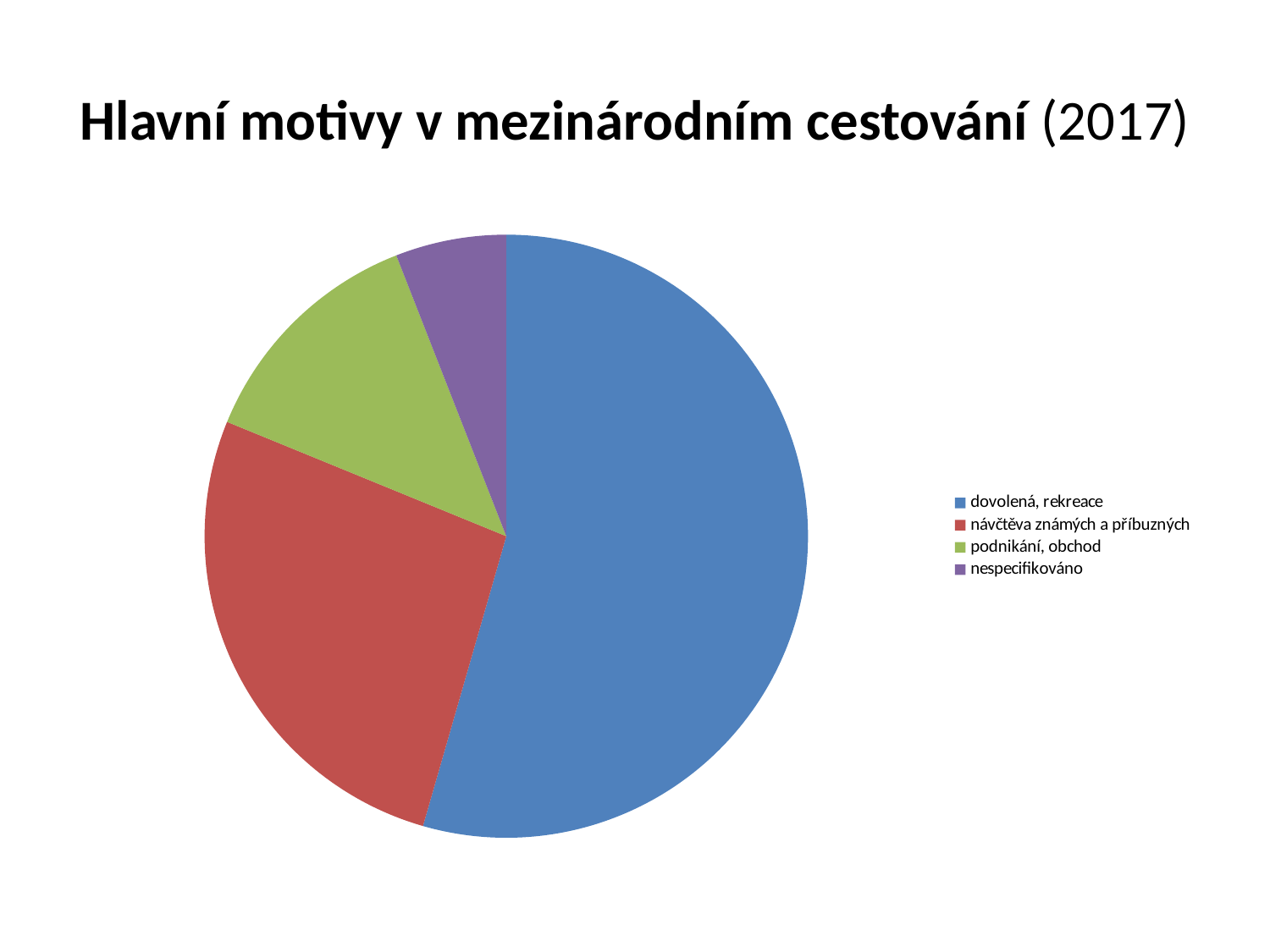
What kind of chart is shown on the slide? pie chart Does the slice for dovolená, rekreace take up more or less than half of the pie? more Which category has the largest slice of the pie? dovolená, rekreace What is the title of the slide's chart? Hlavní motivy v mezinárodním cestování (2017) What colour is the slice for podnikání, obchod? green Which slice is larger: dovolená, rekreace or návčtěva známých a příbuzných? dovolená, rekreace Which category has the smallest slice of the pie? nespecifikováno How many slices does the pie chart have? 4 Which slice is larger: návčtěva známých a příbuzných or podnikání, obchod? návčtěva známých a příbuzných Which category is the second largest slice of the pie? návčtěva známých a příbuzných